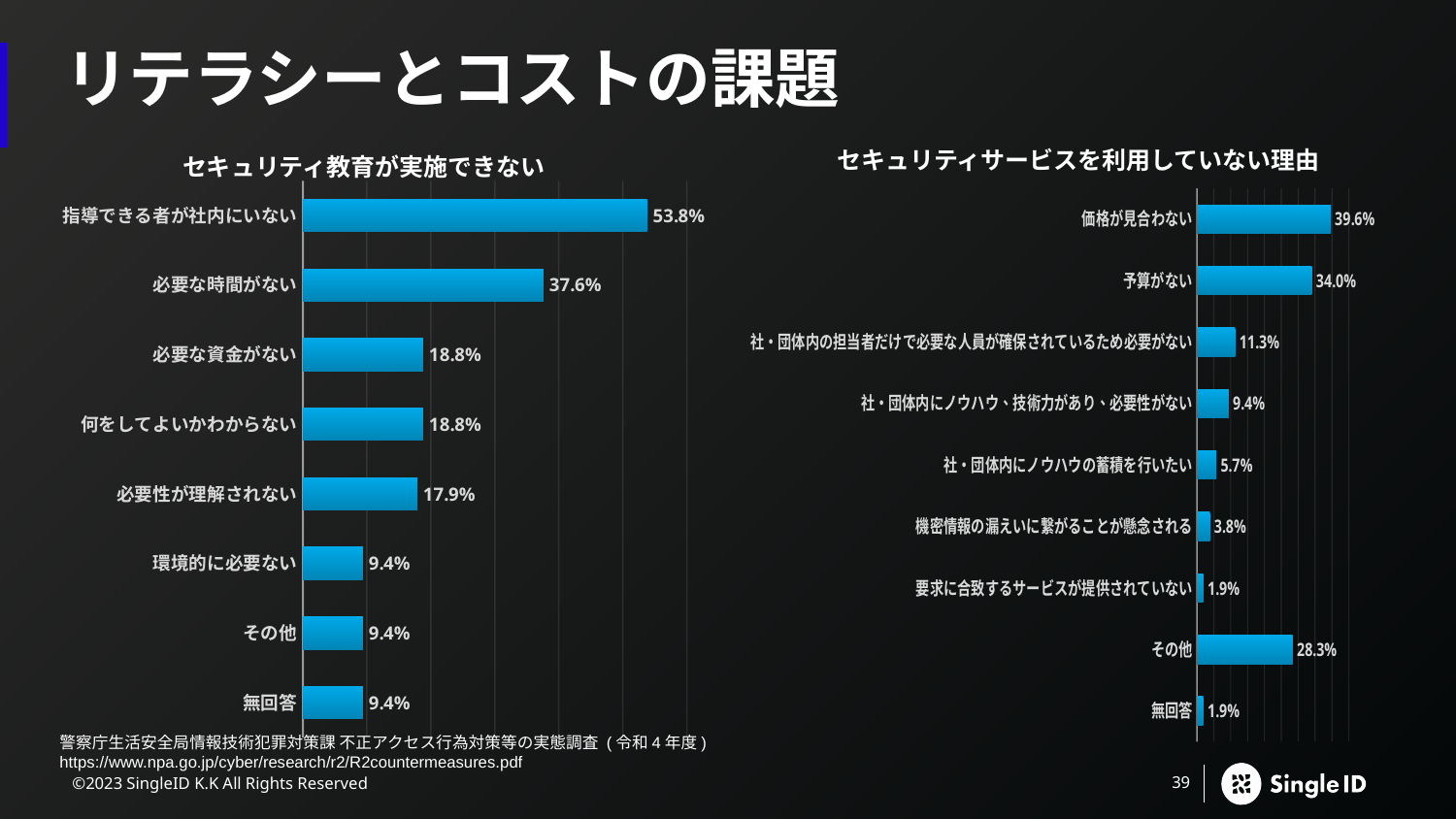
In the chart titled セキュリティ教育が実施できない, what is the value for 指導できる者が社内にいない? 53.8% In the chart titled セキュリティサービスを利用していない理由, what is the value for 価格が見合わない? 39.6% In the chart titled セキュリティ教育が実施できない, how many categories are shown? 8 In the chart titled セキュリティサービスを利用していない理由, which is larger: 予算がない or その他? 予算がない In the chart titled セキュリティ教育が実施できない, what is the difference between 指導できる者が社内にいない and 必要な時間がない? 16.2% What type of chart is the chart titled セキュリティ教育が実施できない? Bar chart In the chart titled セキュリティサービスを利用していない理由, which category has the highest value? 価格が見合わない In the chart titled セキュリティ教育が実施できない, which category has the highest value? 指導できる者が社内にいない In the chart titled セキュリティサービスを利用していない理由, what is the difference between 価格が見合わない and 予算がない? 5.6% In the chart titled セキュリティ教育が実施できない, what is the value for 必要な時間がない? 37.6% In the chart titled セキュリティサービスを利用していない理由, how many categories are shown? 9 In the chart titled セキュリティサービスを利用していない理由, what is the value for その他? 28.3%